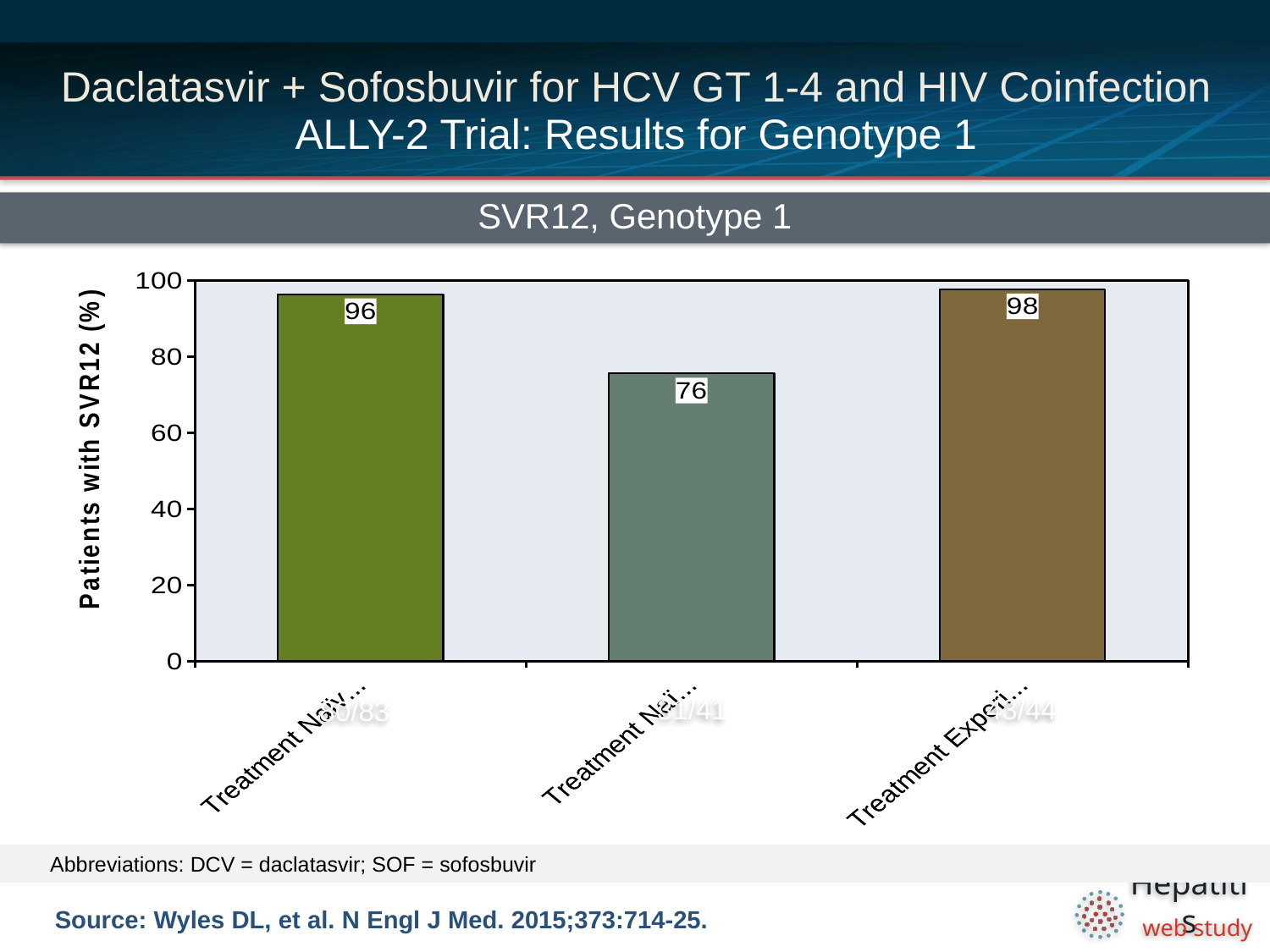
What is the difference between the rightmost bar's value and the middle bar's value? 22 What is the title of the chart? SVR12, Genotype 1 Which is larger, the value of the leftmost bar or the value of the rightmost bar? the rightmost bar What is the value shown on the leftmost bar of the chart? 96 Is the value of the middle bar greater or less than 80? less What is the value shown on the middle bar of the chart? 76 How many bars are plotted in the chart? 3 What is the value shown on the rightmost bar of the chart? 98 What kind of chart is shown on the slide? bar chart What is the difference between the leftmost bar's value and the middle bar's value? 20 Which bar has the lowest value? the middle bar Which bar has the highest value? the rightmost bar